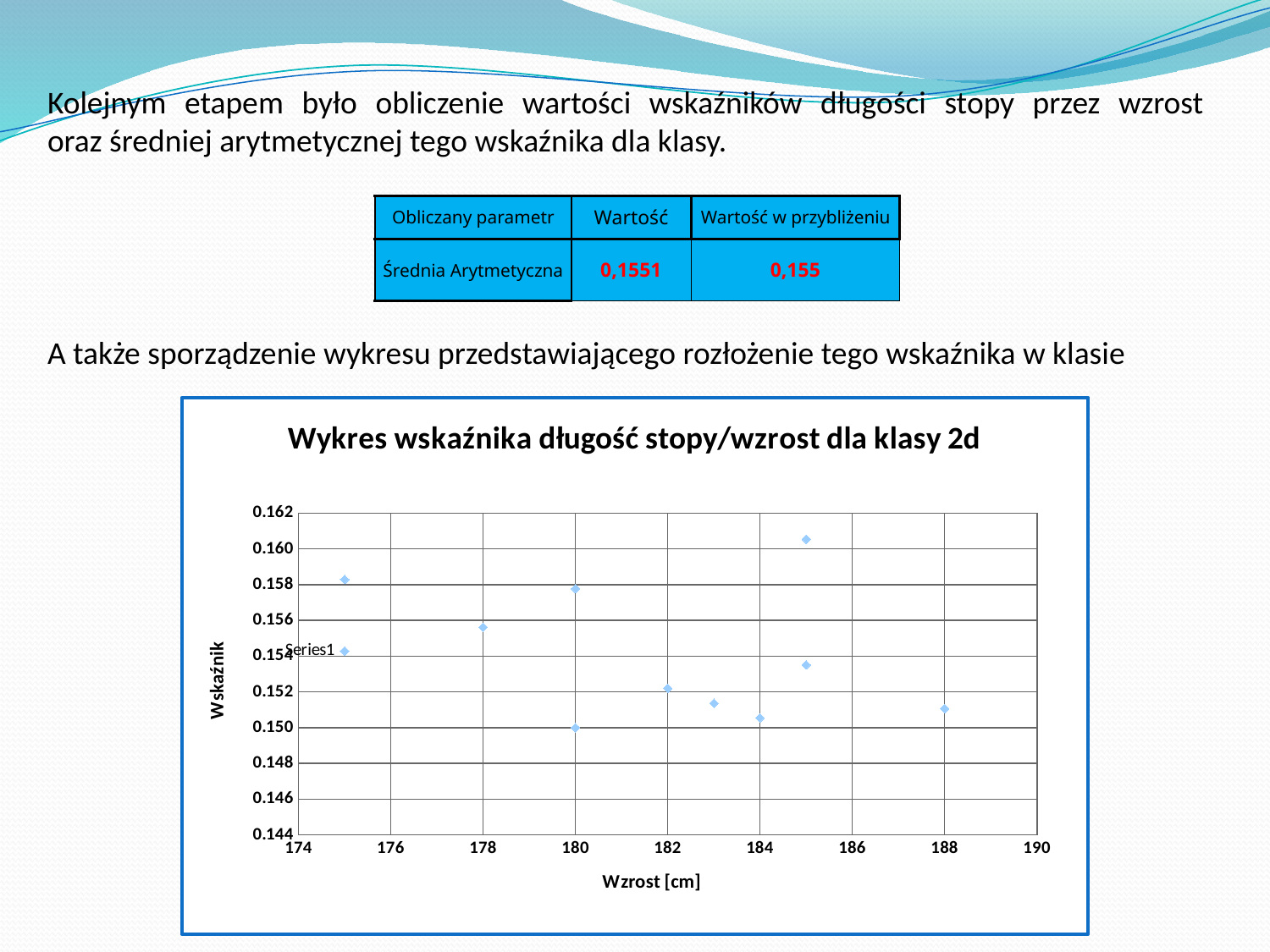
Is the Wskaźnik value for the point at 188 cm greater or less than 0.152? less Which has the larger Wskaźnik value: the point at 178 cm or the point at 188 cm? 178 cm At which height (Wzrost) is the highest Wskaźnik value plotted? 185 Is the Wskaźnik value for the point at 178 cm greater or less than 0.154? greater What is the label of the x axis of the chart? Wzrost [cm] What kind of chart is shown on the slide? scatter chart How many data points are plotted on the chart? 11 How many series does the chart's legend list? 1 Is the Wskaźnik value for the point at 183 cm greater or less than 0.152? less What is the title of the chart? Wykres wskaźnika długość stopy/wzrost dla klasy 2d